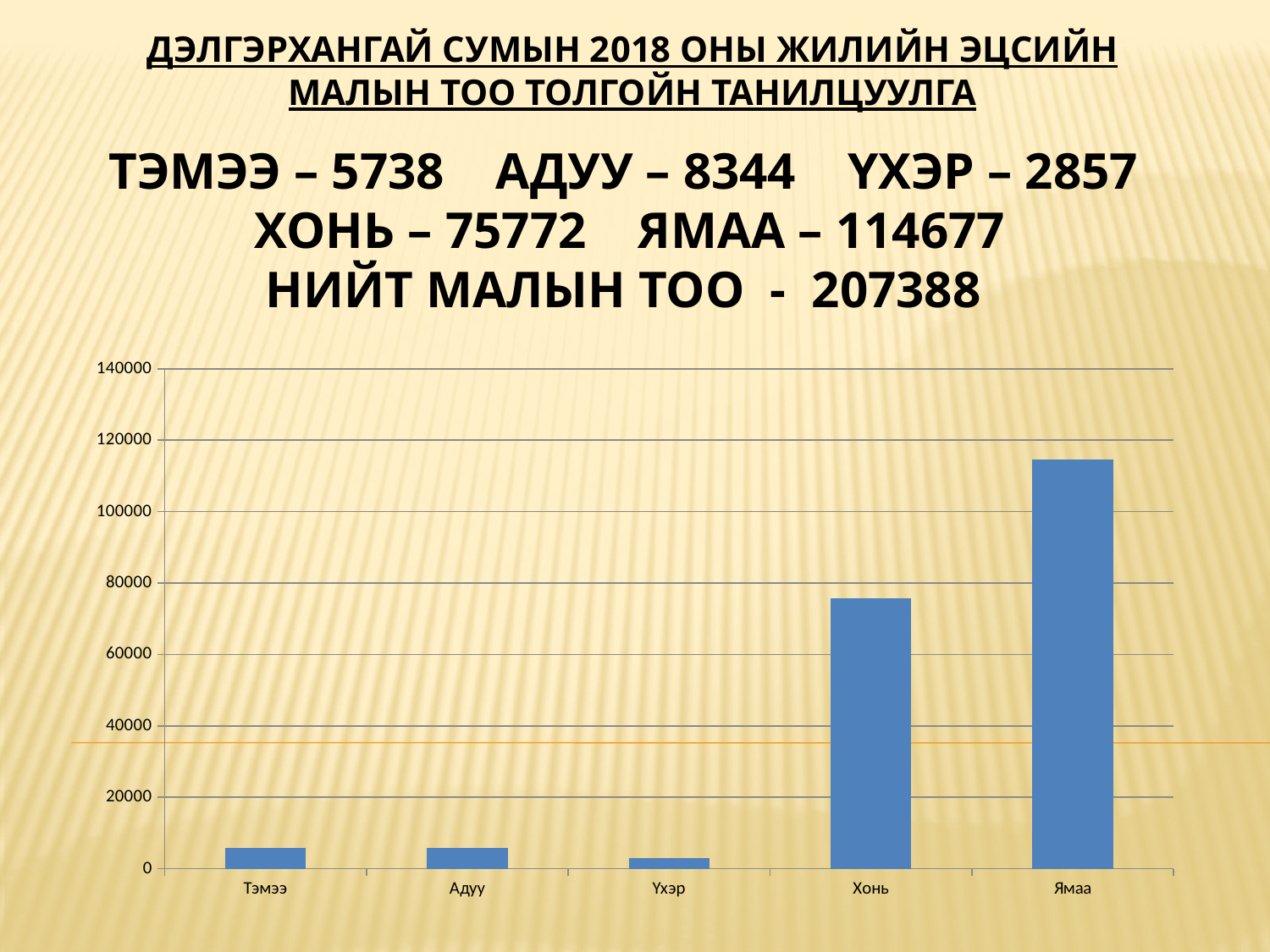
Which is larger, the value for Хонь or the value for Ямаа? Ямаа Is the value for Адуу greater or less than 20000? less Which category has the highest value on the chart? Ямаа What is the value for Ямаа? 114677 What is the total number of livestock (нийт малын тоо) stated on the slide? 207388 What is the difference between the values for Ямаа and Хонь? 38905 Is the value for Хонь greater or less than 60000? greater What is the value for Тэмээ? 5738 How many categories are plotted on the chart? 5 What is the value for Хонь? 75772 Which category has the lowest value on the chart? Үхэр What kind of chart is shown on the slide? bar chart